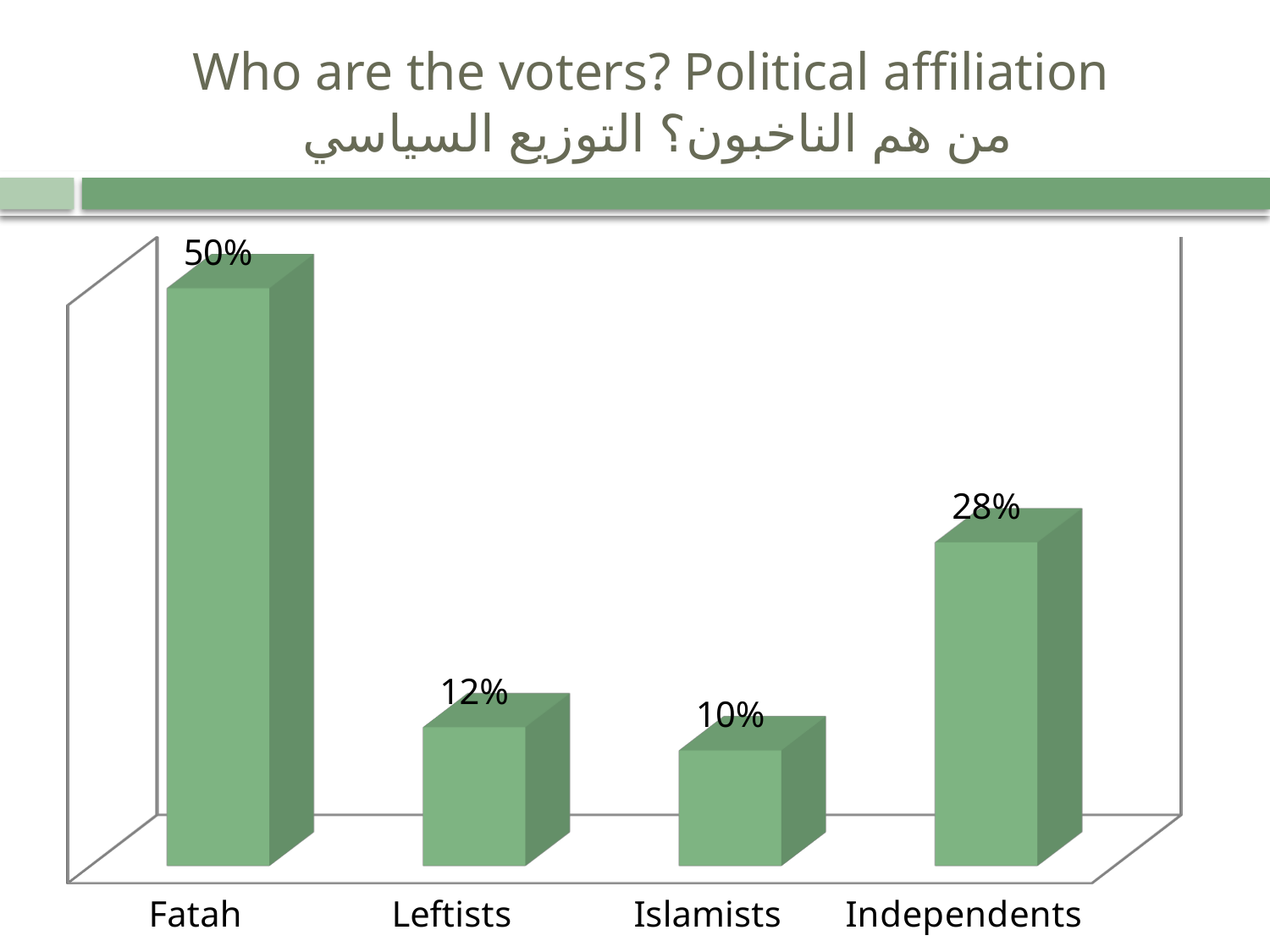
What is the value for Leftists? 12% What is the English title of the slide? Who are the voters? Political affiliation Which category has the lowest value? Islamists What is the value for Islamists? 10% What is the difference between the values for Leftists and Islamists? 2% Which is larger, the value for Independents or the value for Leftists? Independents What is the value for Fatah? 50% How many categories are shown in the chart? 4 What is the difference between the values for Fatah and Independents? 22% What is the value for Independents? 28% What kind of chart is shown on the slide? Bar chart Which category has the highest value? Fatah